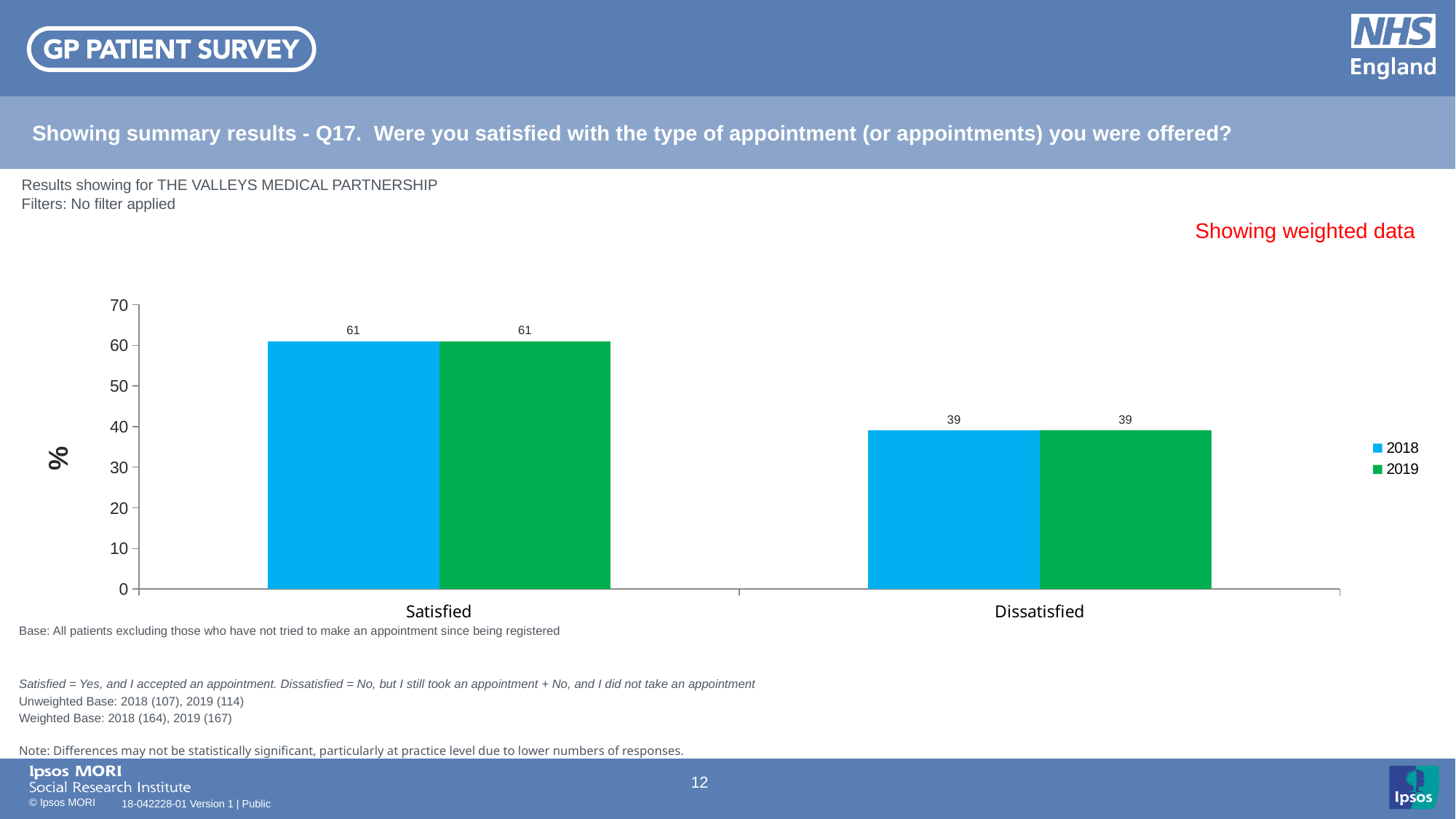
How many series does the legend list? 2 What kind of chart is shown on the slide? bar chart How many categories are shown on the x axis? 2 What is the value for Satisfied in 2018? 61 Is the value for Dissatisfied in 2018 greater or less than 50? less Which category has the highest value in 2018? Satisfied Which is larger: the 2018 value for Satisfied or the 2018 value for Dissatisfied? Satisfied Which category has the lowest value in 2019? Dissatisfied Which colour represents the 2019 series in the legend? green What is the value for Satisfied in 2019? 61 What is the difference between the Satisfied and Dissatisfied values in 2019? 22 What is the value for Dissatisfied in 2019? 39